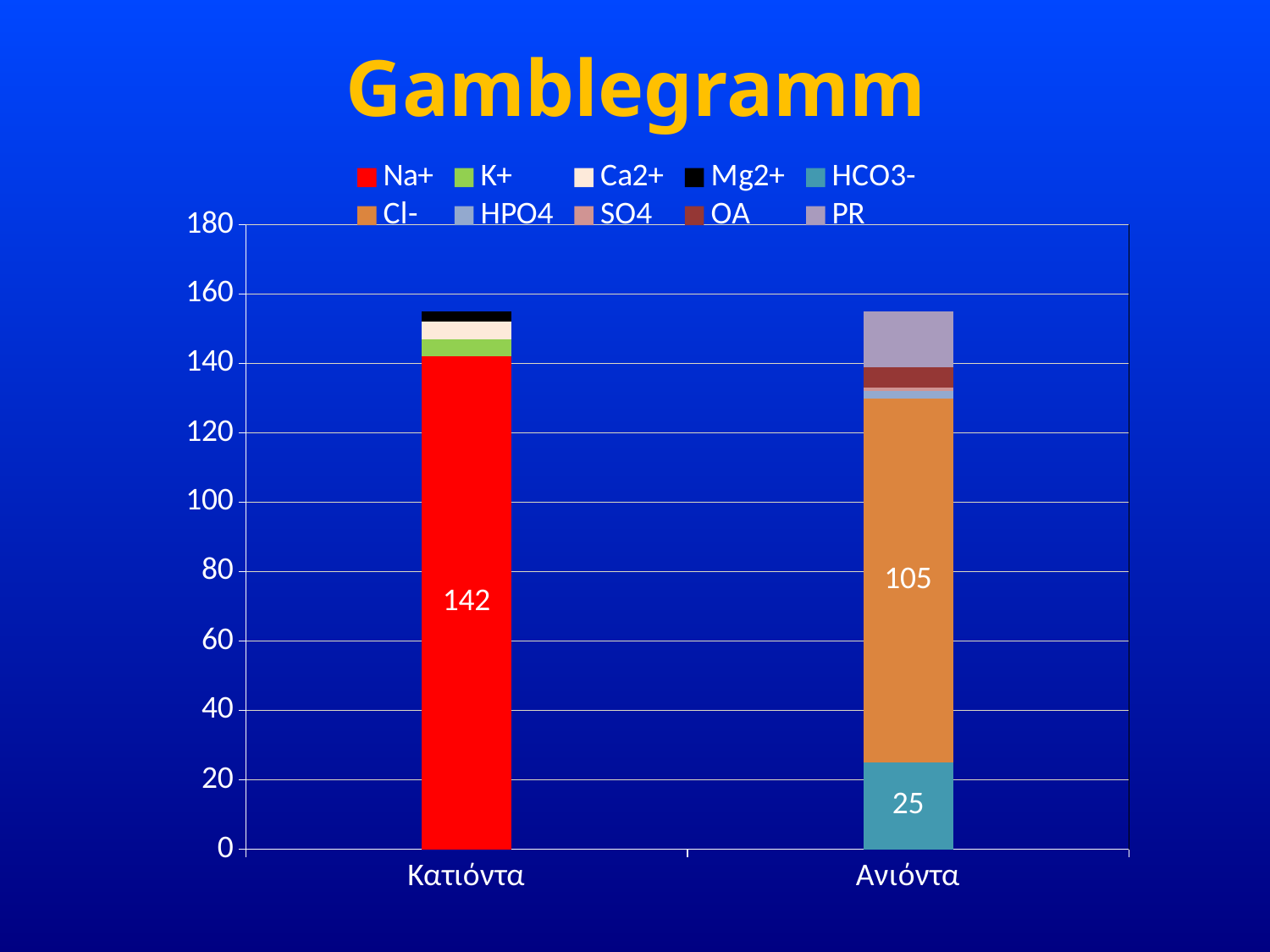
What type of chart is shown on the slide? Stacked bar chart Is the total height of the Κατιόντα bar greater or less than 140? greater Is the total height of the Ανιόντα bar greater or less than 160? less Which is larger, the Na+ value or the Cl- value? Na+ How many series does the legend list? 10 What is the value of Na+ in the Κατιόντα bar? 142 Which series has the largest single value shown in the chart? Na+ What is the difference between the Na+ value (142) and the Cl- value (105)? 37 What is the value of Cl- in the Ανιόντα bar? 105 What is the value of HCO3- in the Ανιόντα bar? 25 How many categories are shown on the x axis? 2 What is the difference between the Cl- value and the HCO3- value in the Ανιόντα bar? 80